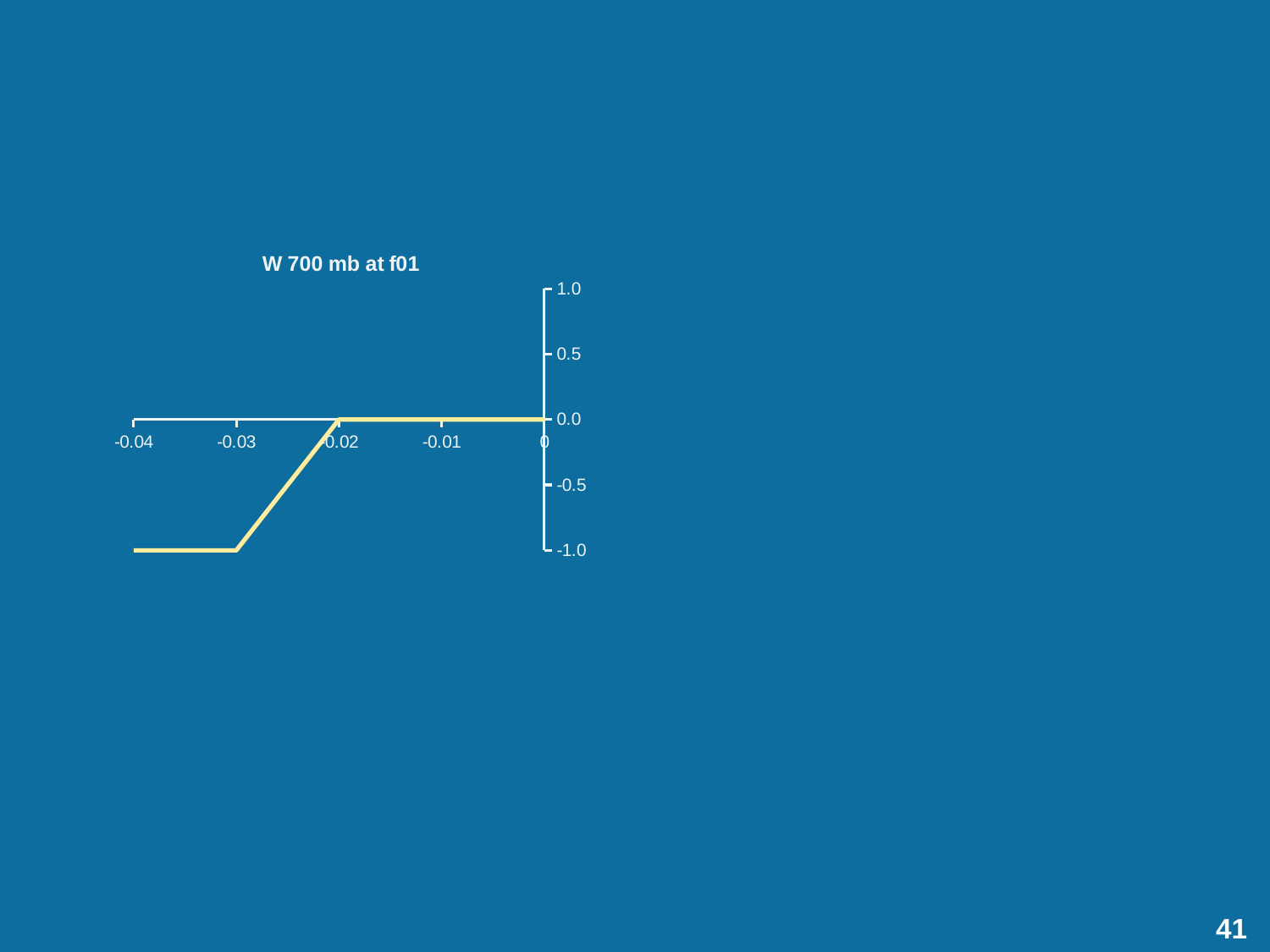
What kind of chart is shown on the slide? line chart What is the value of the line at x = 0? 0.0 What is the value of the line at x = -0.03? -1.0 How many labelled tick marks are on the x axis? 5 What is the value of the line at x = -0.02? 0.0 Is the value of the line at x = -0.01 greater or less than -0.5? greater Is the value of the line at x = -0.025 greater or less than 0.0? less Does the line rise or fall between x = -0.03 and x = -0.02? rise Which is larger, the value at x = -0.03 or the value at x = -0.01? the value at x = -0.01 What is the title of the chart? W 700 mb at f01 What is the value of the line at x = -0.04? -1.0 What is the highest value labelled on the y axis? 1.0